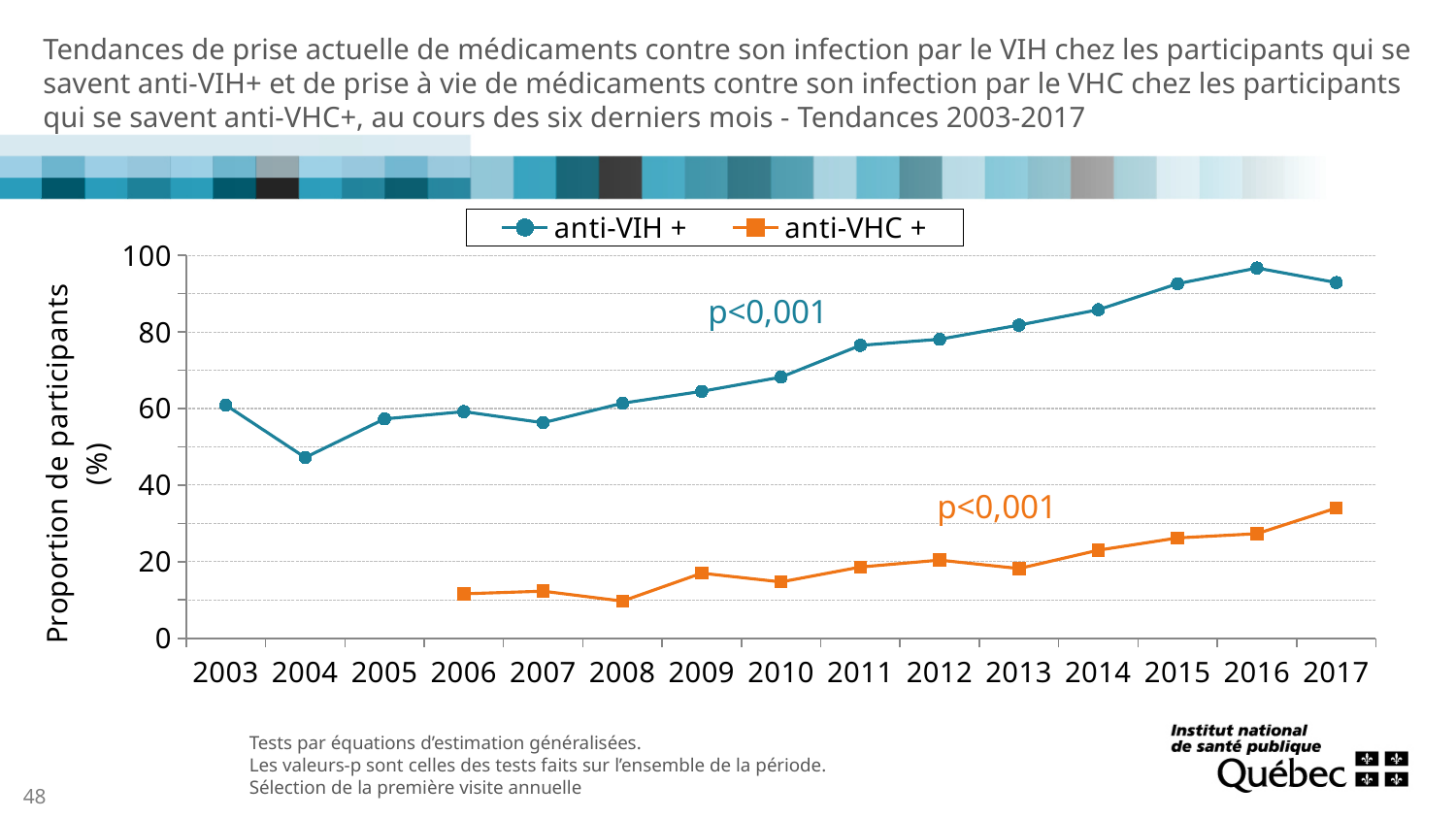
Is the anti-VIH + value for 2004 greater or less than 60? less What kind of chart is shown on the slide? line chart In which year is the anti-VHC + series at its highest? 2017 In which year is the anti-VIH + series at its highest? 2016 How many series does the legend list? 2 Is the anti-VIH + value for 2016 greater or less than 80? greater How many data points are plotted for the anti-VIH + series? 15 In which year is the anti-VIH + series at its lowest? 2004 Which is larger for the anti-VIH + series: the value in 2003 or the value in 2004? 2003 What p-value is annotated next to each series on the chart? p<0,001 How many data points are plotted for the anti-VHC + series? 12 Is the anti-VHC + value for 2017 greater or less than 40? less